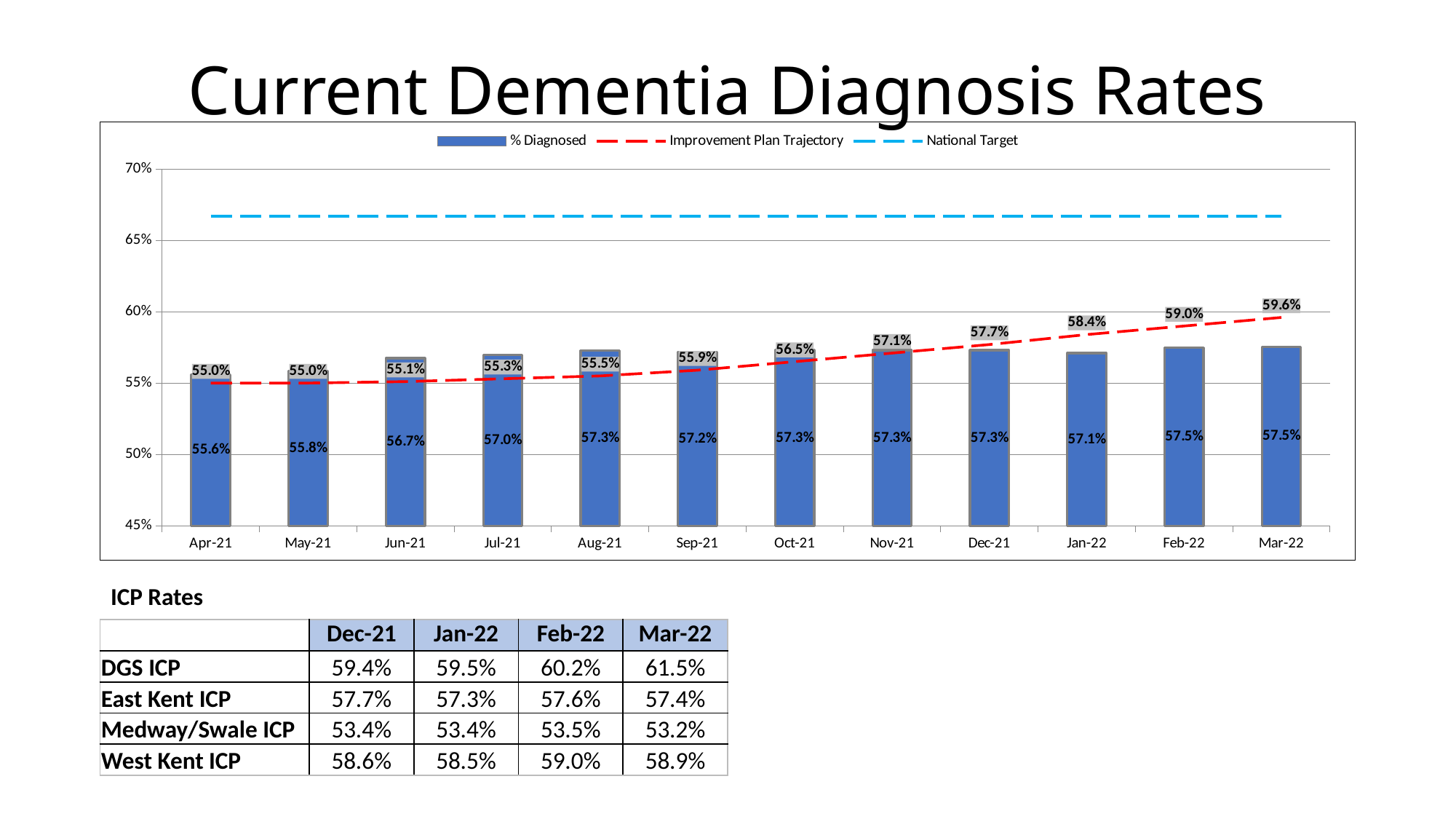
Which month has the lowest % Diagnosed value? Apr-21 What is the % Diagnosed value for Apr-21? 55.6% Is the National Target line greater or less than 65%? greater How many months are shown on the x axis of the chart? 12 What is the Improvement Plan Trajectory value for Mar-22? 59.6% Which is larger, the % Diagnosed value for Jun-21 or for May-21? Jun-21 How many series does the chart legend list? 3 Which month has the highest Improvement Plan Trajectory value? Mar-22 What kind of chart is used to show the % Diagnosed values? Bar chart What is the difference between the % Diagnosed values for Mar-22 and Apr-21? 1.9 percentage points Does the Improvement Plan Trajectory rise or fall from Apr-21 to Mar-22? Rise What is the % Diagnosed value for Jan-22? 57.1%